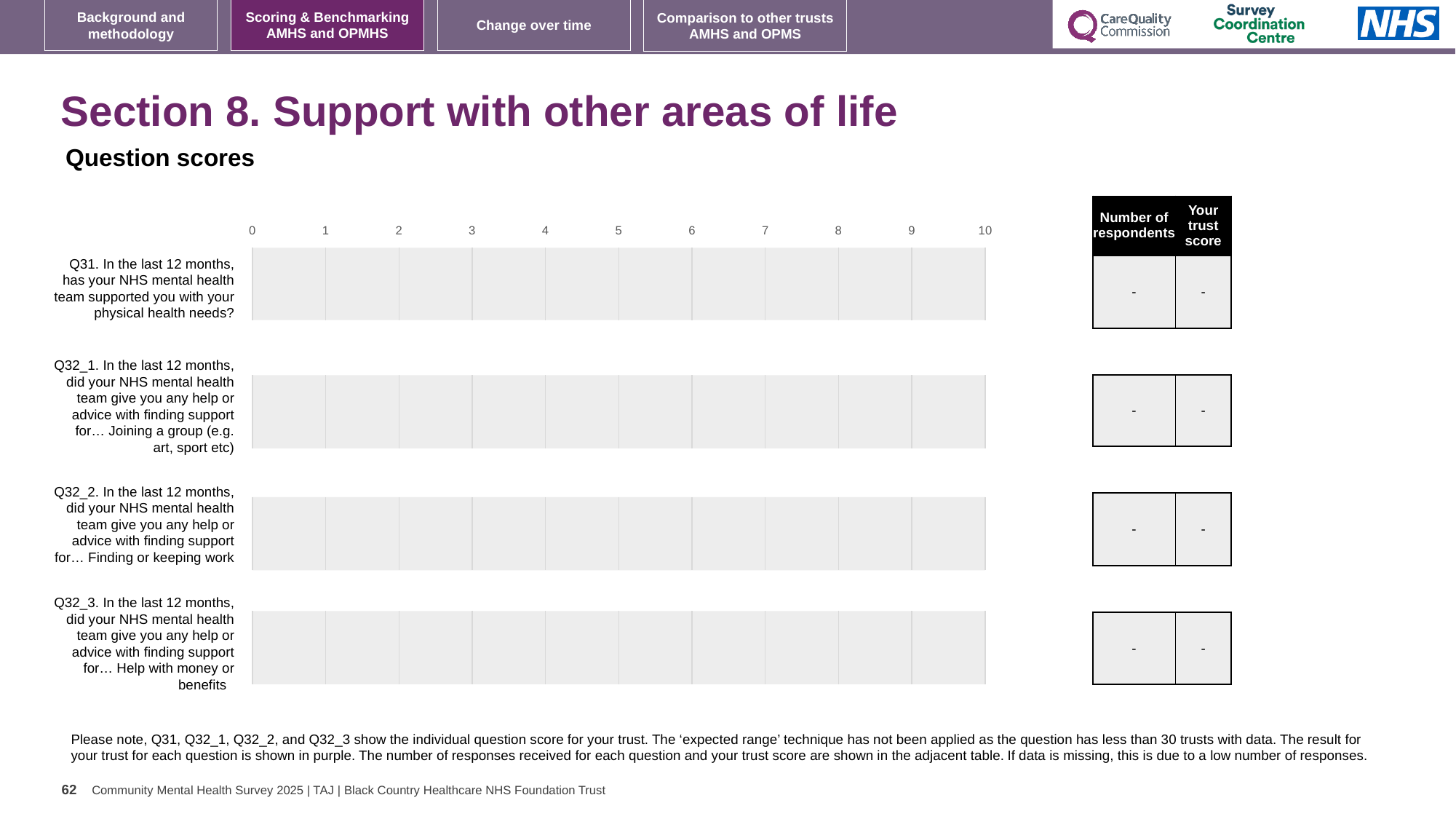
What is the 'Your trust score' shown in the table for Q32_3? - What kind of chart is shown on the slide? bar chart Which question label appears last (at the bottom) of the chart? Q32_3 What is the 'Your trust score' shown in the table for Q31? - What is the 'Number of respondents' shown in the table for Q32_1? - Which question label appears first (at the top) of the chart? Q31 What is the maximum value shown on the chart's horizontal axis? 10 What is the 'Number of respondents' shown in the table for Q32_2? - How many questions (categories) are listed on the chart? 4